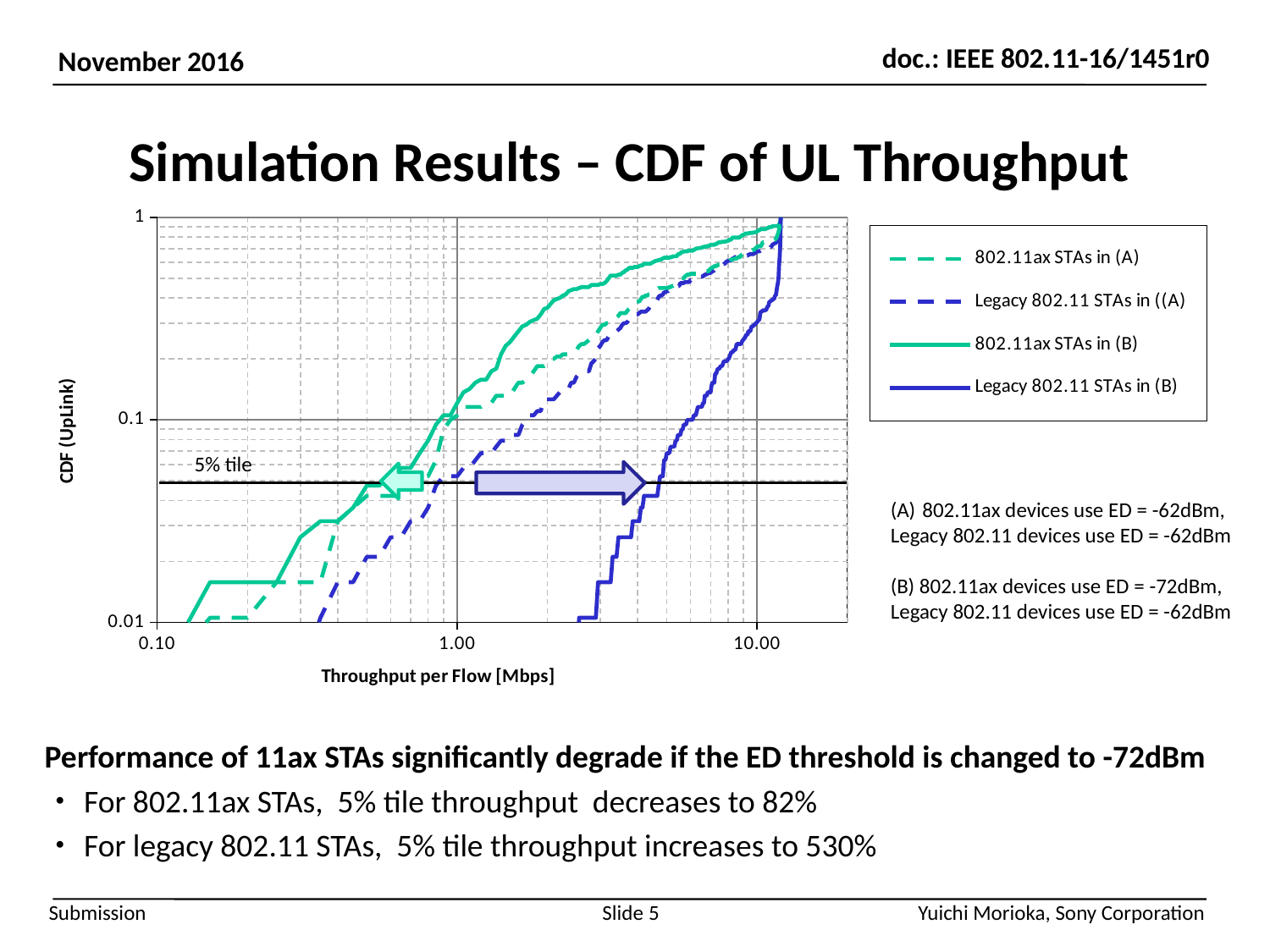
What is the label of the x axis? Throughput per Flow [Mbps] Is the throughput of 802.11ax STAs in (B) at the 5% tile line greater or less than 1.00 Mbps? less What is the title of the chart? Simulation Results – CDF of UL Throughput How many series does the legend list? 4 What kind of chart is shown on the slide? Line chart At a CDF of 0.1, which series has the higher throughput: 802.11ax STAs in (B) or Legacy 802.11 STAs in (B)? Legacy 802.11 STAs in (B) At the 5% tile line, which series has the higher throughput: 802.11ax STAs in (A) or Legacy 802.11 STAs in (B)? Legacy 802.11 STAs in (B) Is the throughput of Legacy 802.11 STAs in (B) at the 5% tile line greater or less than 1.00 Mbps? greater Which series reaches a CDF of 0.1 at the lowest throughput? 802.11ax STAs in (B) Is the throughput of Legacy 802.11 STAs in (B) at the 5% tile line greater or less than 10.00 Mbps? less Which series reaches a CDF of 0.1 at the highest throughput? Legacy 802.11 STAs in (B) Do the CDF curves rise or fall as throughput increases along the x axis? Rise